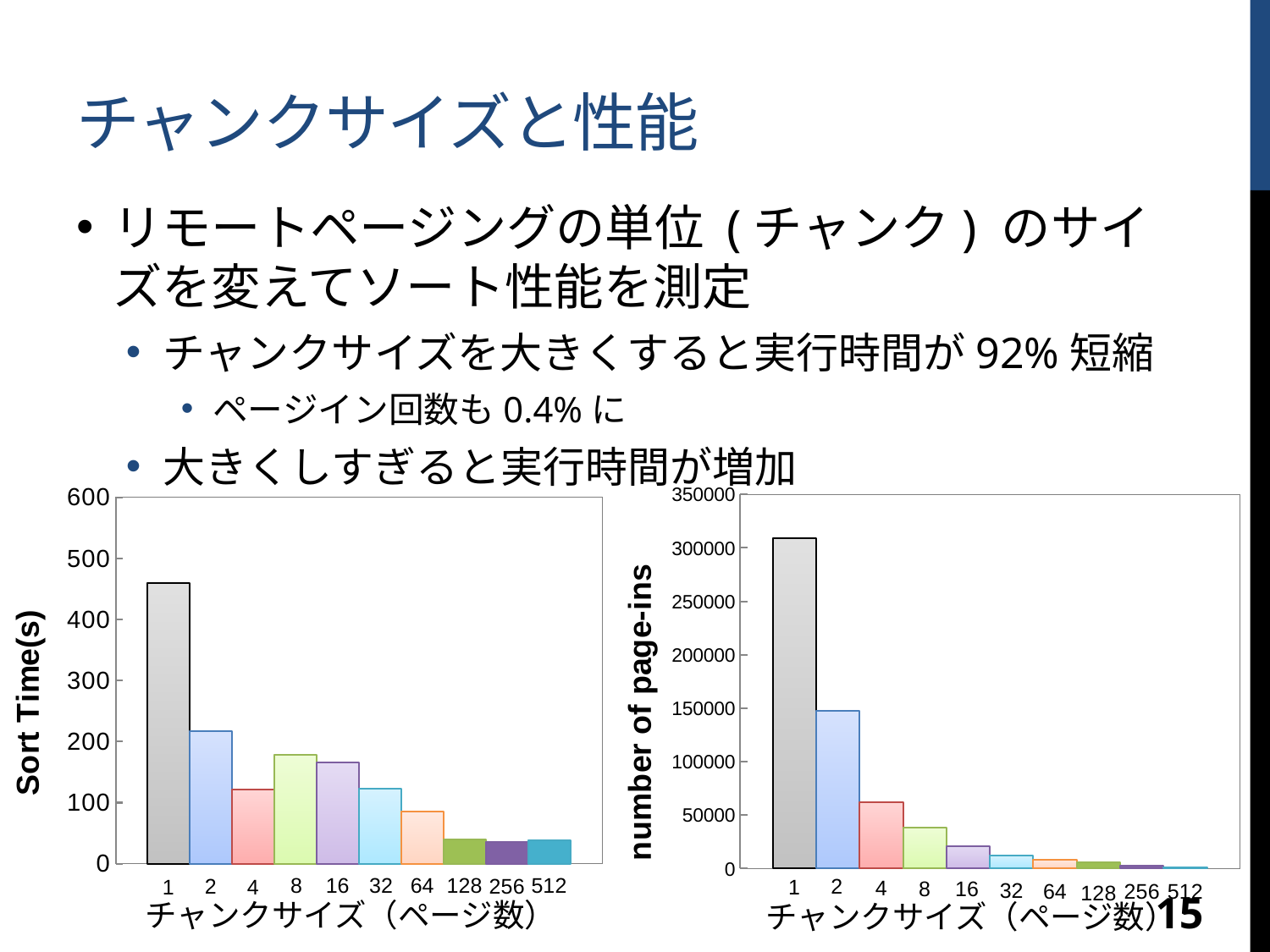
In the left chart (Sort Time(s)), which has the larger sort time, chunk size 4 or chunk size 8? 8 In the right chart (number of page-ins), do the values rise or fall as the chunk size increases along the x axis? fall In the left chart (Sort Time(s)), which chunk size has the highest sort time? 1 In the left chart (Sort Time(s)), is the value for chunk size 1 greater or less than 400? greater What kind of chart is the left chart with the y-axis labelled Sort Time(s)? bar chart In the right chart (number of page-ins), is the value for chunk size 8 greater or less than 50000? less In the left chart (Sort Time(s)), is the value for chunk size 64 greater or less than 100? less In the left chart (Sort Time(s)), which has the larger sort time, chunk size 2 or chunk size 4? 2 What is the y-axis title of the right chart? number of page-ins In the left chart (Sort Time(s)), how many chunk size categories are shown on the x axis? 10 In the right chart (number of page-ins), which chunk size has the highest number of page-ins? 1